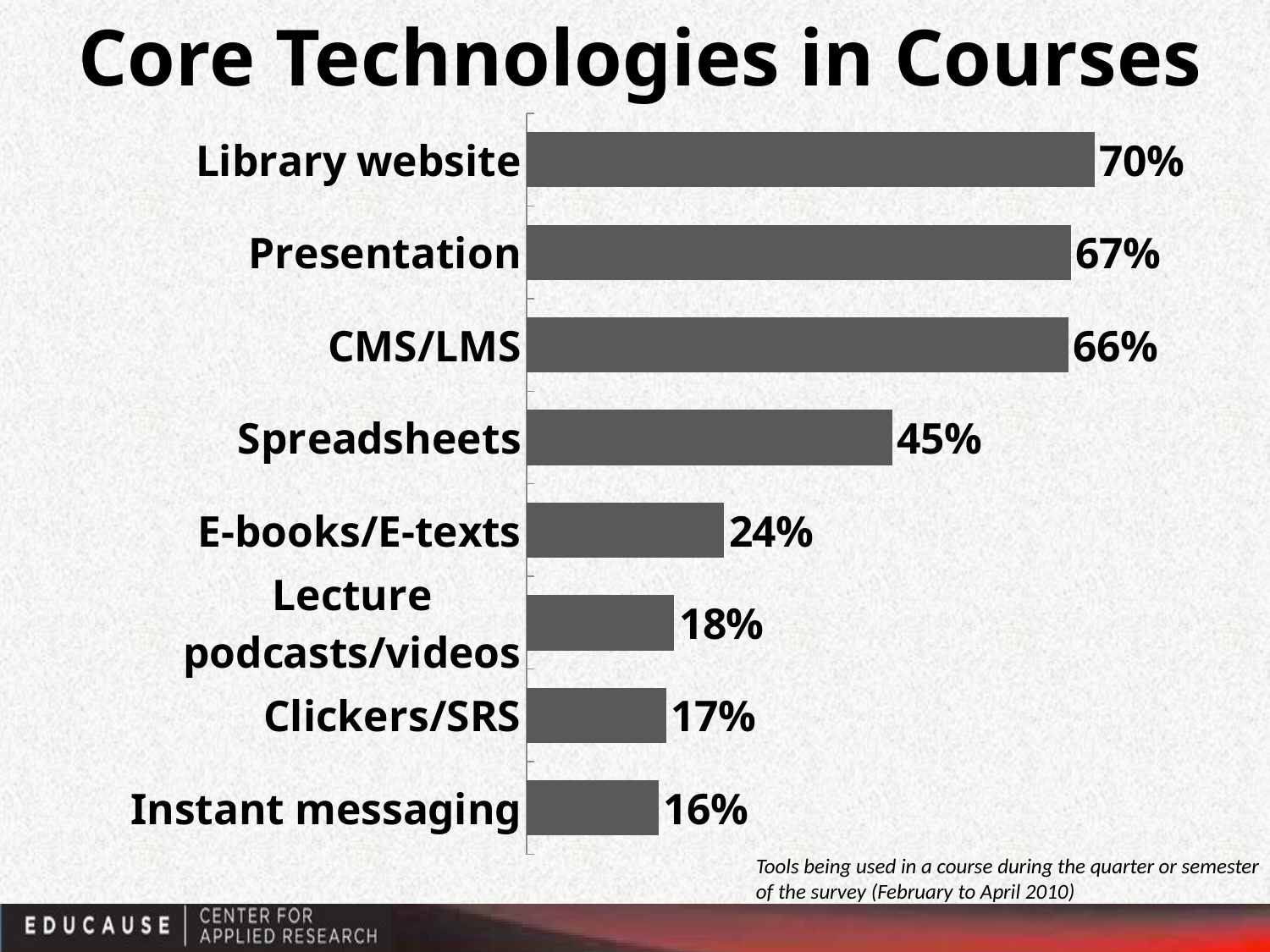
What is the difference between the values for Library website and Spreadsheets? 25% Which has a larger value, Spreadsheets or E-books/E-texts? Spreadsheets What is the value for Spreadsheets? 45% Which technology has the lowest percentage? Instant messaging What percentage is shown for Library website? 70% What percentage is shown for Lecture podcasts/videos? 18% What is the title of the slide? Core Technologies in Courses Which technology has the highest percentage? Library website Which has a larger value, Presentation or CMS/LMS? Presentation What kind of chart is shown on the slide? Bar chart How many technologies are shown in the chart? 8 What is the difference between the values for E-books/E-texts and Clickers/SRS? 7%